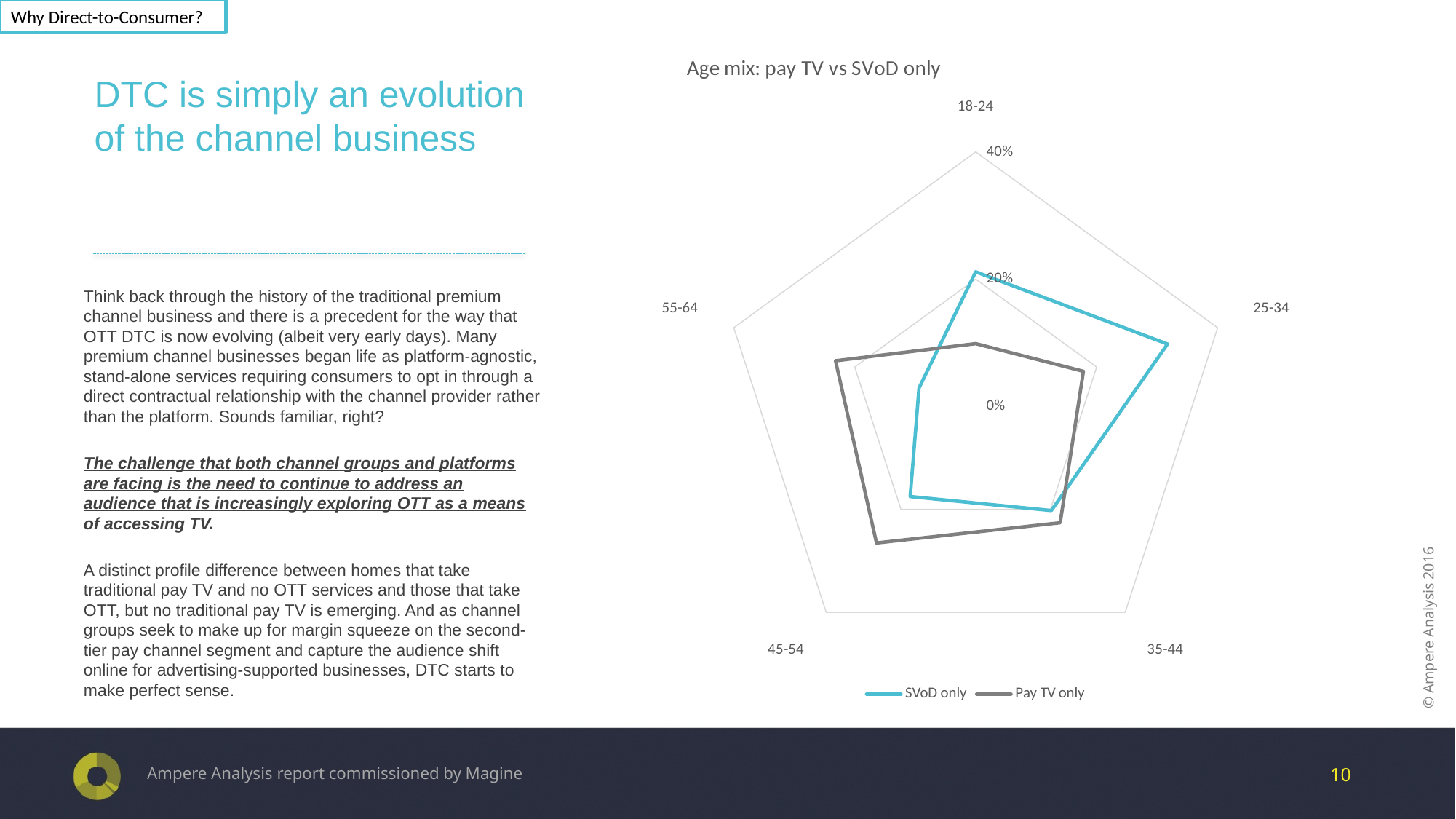
Which age group has the lowest value for the SVoD only series? 55-64 Is the Pay TV only value for 45-54 greater or less than 20%? greater What is the title of the chart? Age mix: pay TV vs SVoD only Is the Pay TV only value for 18-24 greater or less than 20%? less How many series does the chart legend list? 2 How many age categories are plotted on the chart? 5 Is the SVoD only value for 25-34 greater or less than 20%? greater Which age group has the highest value for the SVoD only series? 25-34 Which age group has the lowest value for the Pay TV only series? 18-24 What kind of chart is shown on the slide? Radar chart For the 25-34 age group, which series has the larger value, SVoD only or Pay TV only? SVoD only For the 55-64 age group, which series has the larger value, SVoD only or Pay TV only? Pay TV only